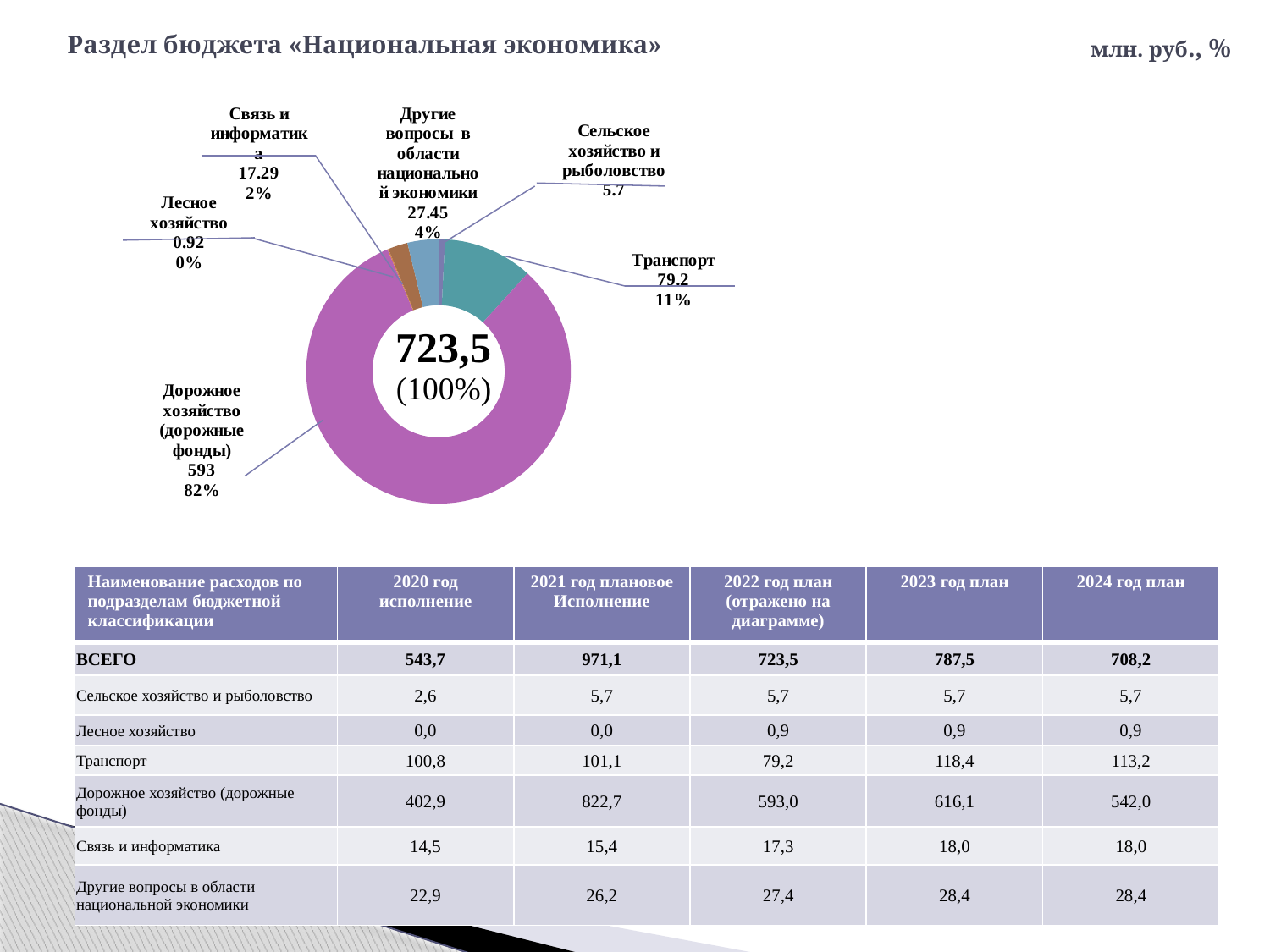
What value is shown for Транспорт on the chart? 79.2 What share of the chart does Дорожное хозяйство (дорожные фонды) represent? 82% What value is shown for Другие вопросы в области национальной экономики on the chart? 27.45 How many categories are shown in the chart? 6 What kind of chart is shown on the slide? Doughnut (pie) chart What value is shown for Лесное хозяйство on the chart? 0.92 What share of the chart does Транспорт represent? 11% Which category has the smallest slice in the chart? Лесное хозяйство What value is shown for Дорожное хозяйство (дорожные фонды) on the chart? 593 What value is shown for Связь и информатика on the chart? 17.29 Which category has the largest slice in the chart? Дорожное хозяйство (дорожные фонды) What total value is shown in the centre of the chart? 723,5